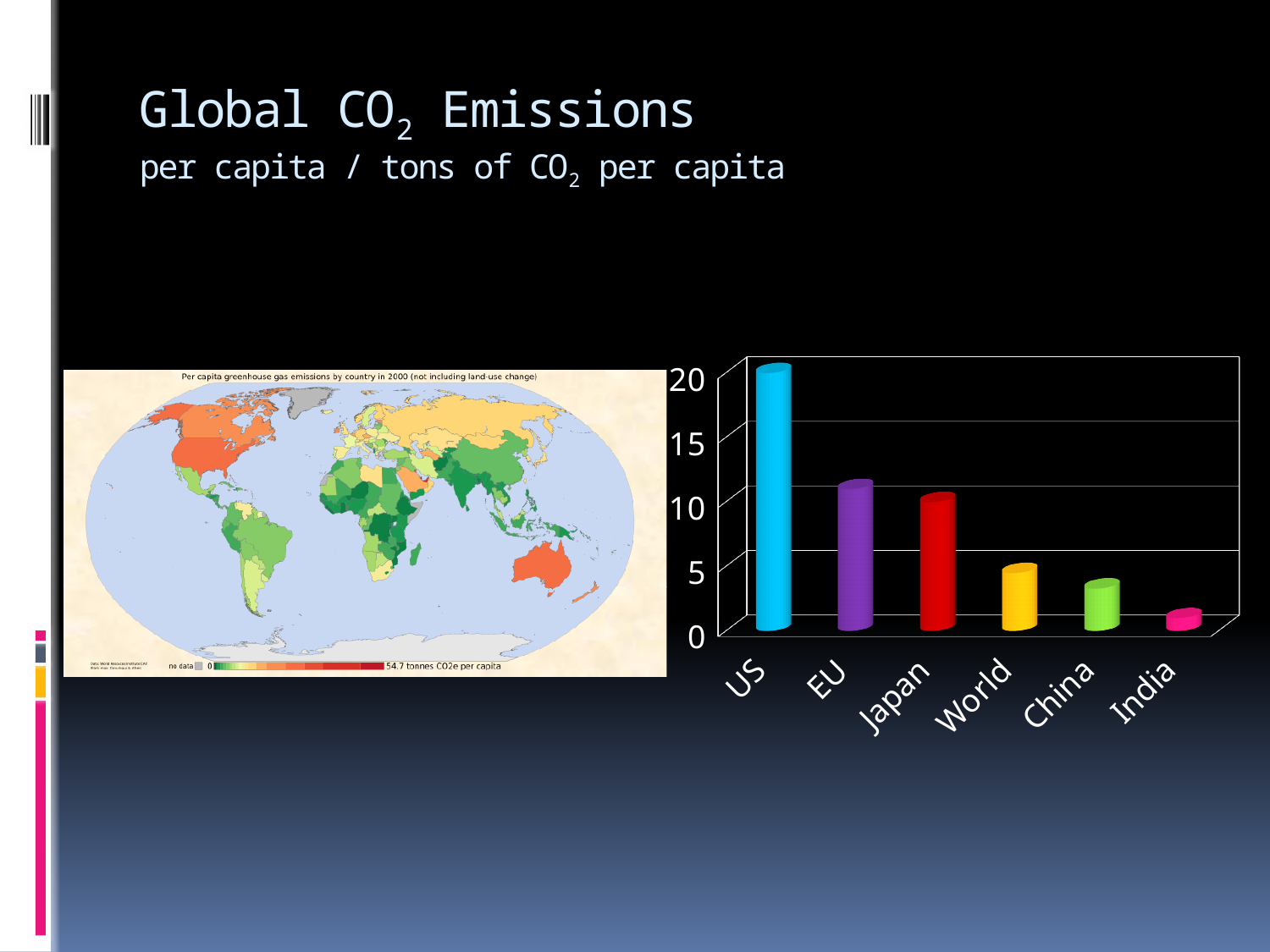
In the bar chart, is the value for Japan greater or less than 15? less In the bar chart, which category has the highest value? US What kind of chart is shown on the right side of the slide? bar chart In the bar chart, which category has the lowest value? India In the bar chart, is the value for World greater or less than 10? less What is the title of the slide containing the bar chart? Global CO2 Emissions In the bar chart, is the value for EU greater or less than 5? greater In the bar chart, do the values rise or fall moving from left to right along the x axis? fall In the bar chart, which has the larger value, US or China? US In the bar chart, how many categories are shown on the x axis? 6